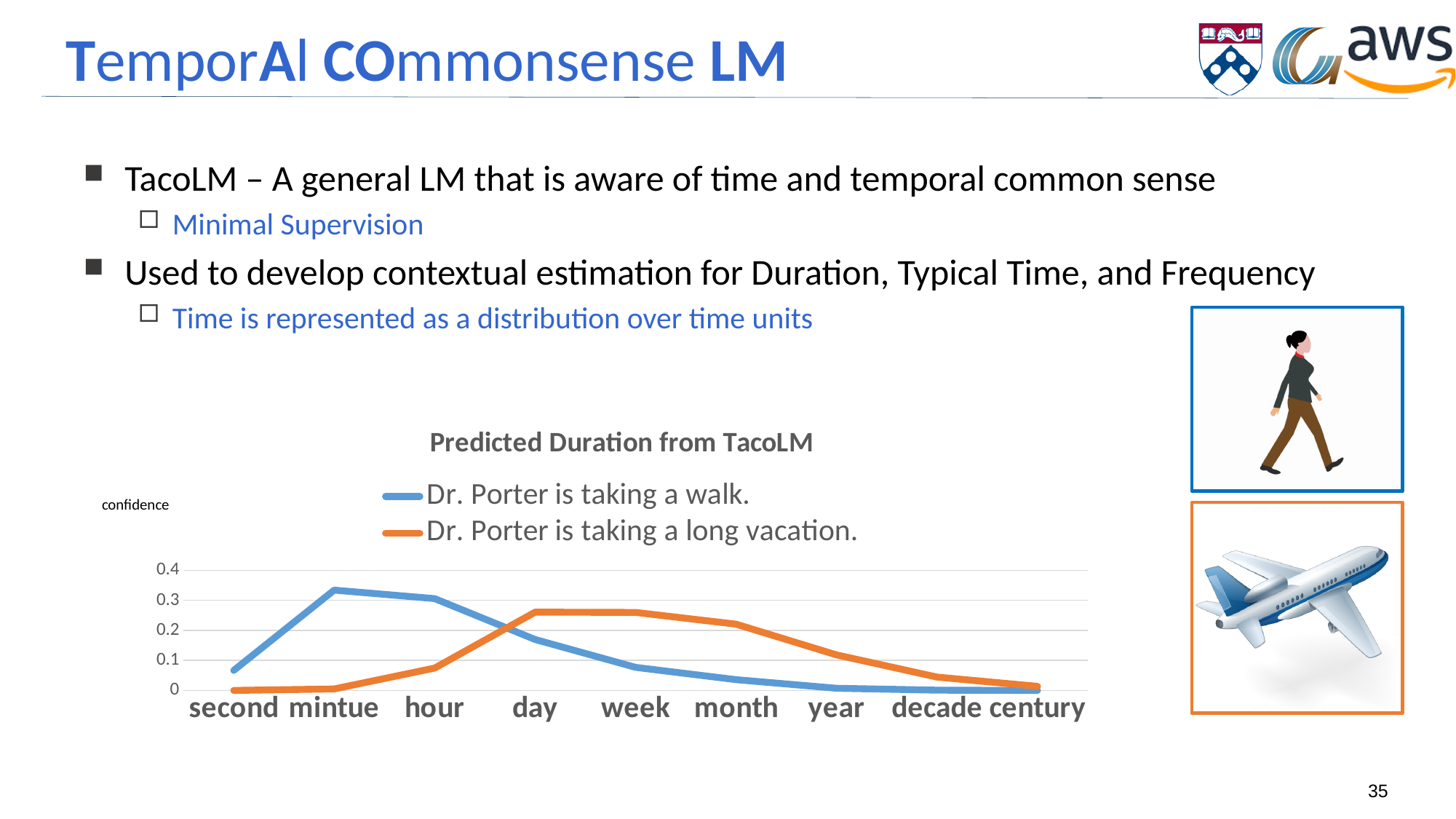
Is the confidence for "Dr. Porter is taking a walk." at week greater or less than 0.1? less Is the confidence for "Dr. Porter is taking a long vacation." at second greater or less than 0.1? less At month, which series has the higher confidence: "Dr. Porter is taking a walk." or "Dr. Porter is taking a long vacation."? Dr. Porter is taking a long vacation. Does the confidence for "Dr. Porter is taking a walk." rise or fall from mintue to century? fall How many series does the legend of the chart list? 2 For which time unit does the series "Dr. Porter is taking a walk." reach its highest confidence? mintue What label is given to the vertical axis of the chart? confidence What is the title of the chart? Predicted Duration from TacoLM Is the confidence for "Dr. Porter is taking a walk." at mintue greater or less than 0.3? greater How many time-unit categories are shown on the x axis of the chart? 9 What kind of chart is shown on the slide? line chart